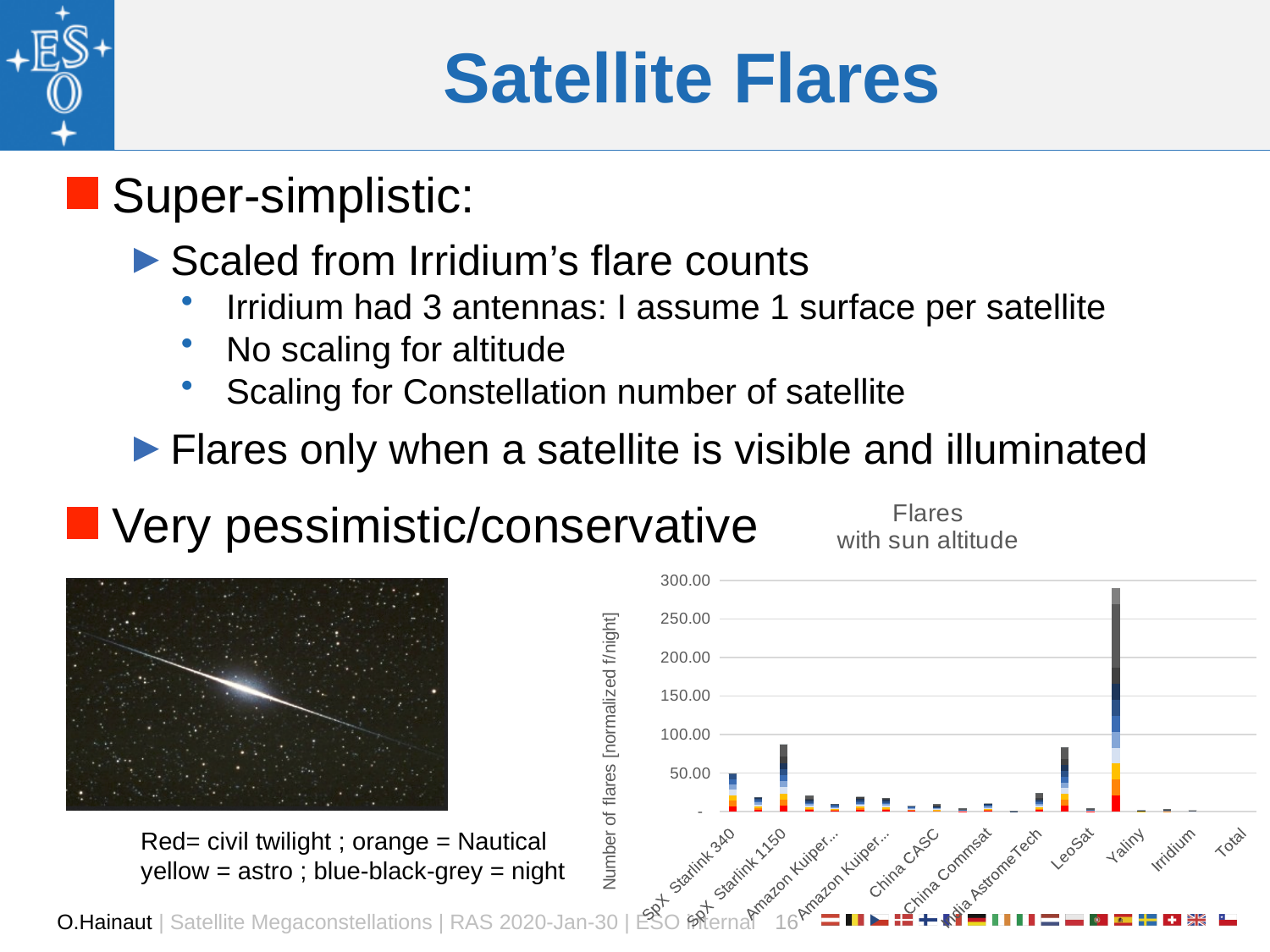
How many category labels are readable along the horizontal axis of the chart? 11 What kind of chart is shown on the slide? stacked bar chart Is the value for China CASC greater or less than 50.00? less Is the value for Irridium greater or less than 50.00? less What is the highest value shown on the vertical axis of the chart? 300.00 Is the value for SpX Starlink 340 greater or less than 100.00? less What is the last category label on the horizontal axis of the chart? Total What is the label of the vertical axis of the chart? Number of flares [normalized f/night] Which is larger, the bar for SpX Starlink 340 or the bar for Irridium? SpX Starlink 340 What is the title of the chart on the slide? Flares with sun altitude